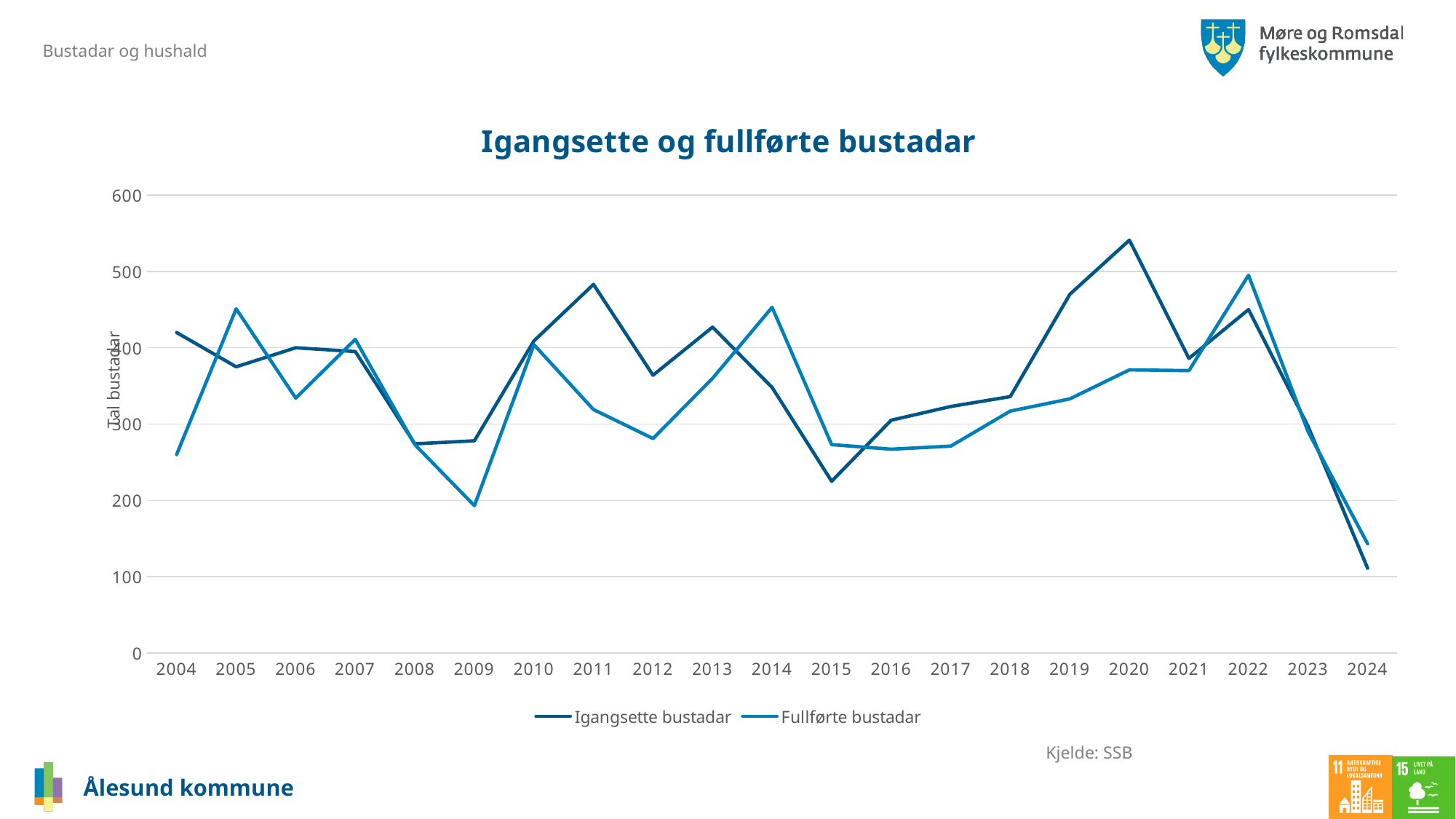
What kind of chart is shown on the slide? line chart How many series does the legend list? 2 In 2011, which series has the larger value, Igangsette bustadar or Fullførte bustadar? Igangsette bustadar Do the values for Igangsette bustadar rise or fall from 2022 to 2024? fall In which year is the value for Igangsette bustadar highest? 2020 Is the value for Igangsette bustadar in 2015 greater or less than 300? less In 2005, which series has the larger value, Igangsette bustadar or Fullførte bustadar? Fullførte bustadar In which year is the value for Fullførte bustadar highest? 2022 Is the value for Fullførte bustadar in 2009 greater or less than 200? less In which year is the value for Igangsette bustadar lowest? 2024 Is the value for Igangsette bustadar in 2020 greater or less than 500? greater How many years are shown on the x axis? 21